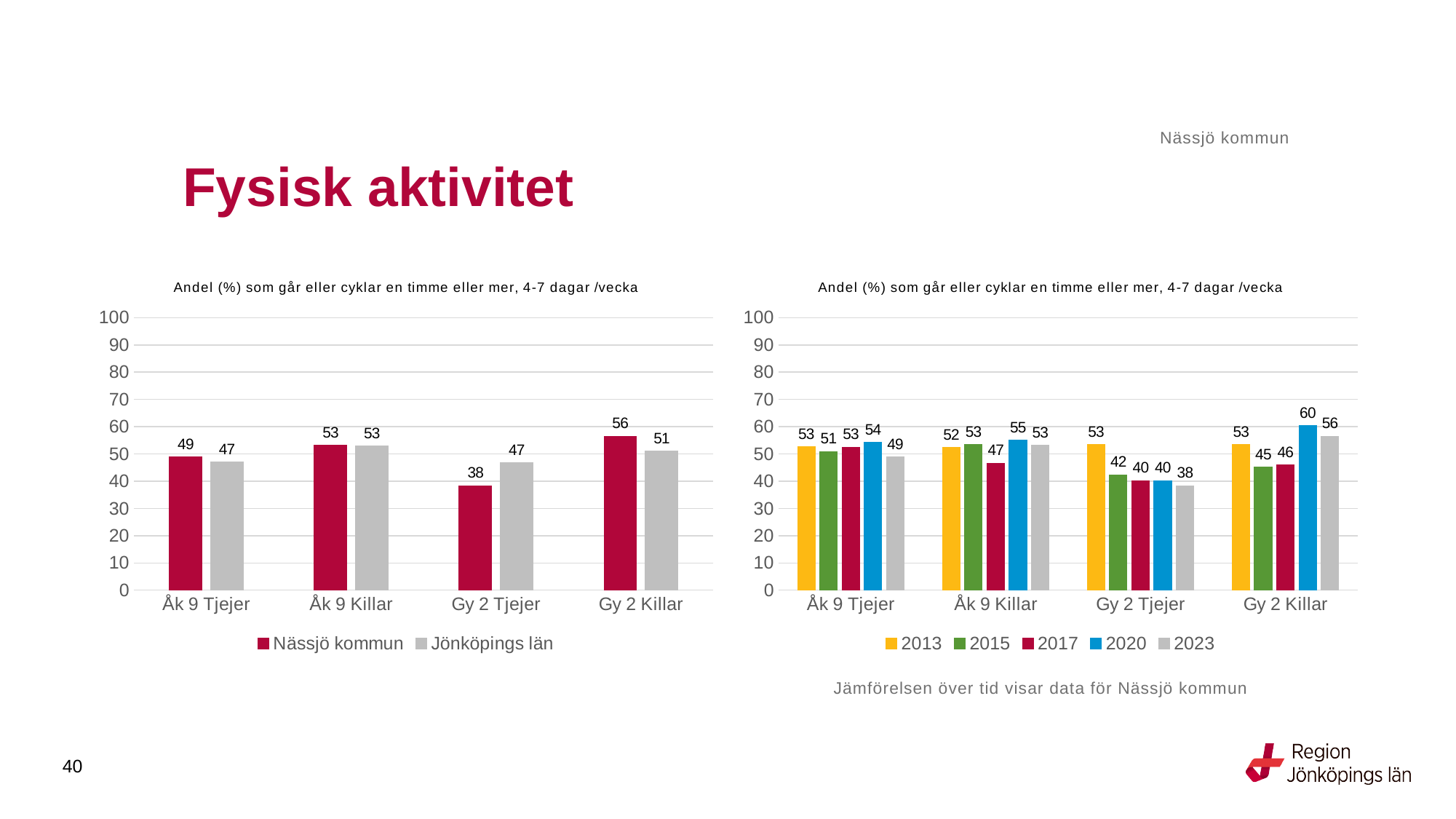
How many series does the legend of the left chart list? 2 How many series does the legend of the right chart list? 5 In the right chart, which year has the lowest value for Gy 2 Tjejer? 2023 In the left chart, what is the value for Jönköpings län for Åk 9 Killar? 53 What kind of chart is the right chart? Bar chart In the right chart, what is the value for 2017 for Åk 9 Killar? 47 In the right chart, how do the values for Gy 2 Tjejer change from 2013 to 2023? They fall In the left chart, what is the difference between Nässjö kommun and Jönköpings län for Gy 2 Tjejer? 9 In the left chart, what is the value for Nässjö kommun for Gy 2 Tjejer? 38 In the left chart, which category has the highest value for Nässjö kommun? Gy 2 Killar In the left chart, which is larger for Gy 2 Killar: Nässjö kommun or Jönköpings län? Nässjö kommun In the right chart, what is the value for 2020 for Gy 2 Killar? 60